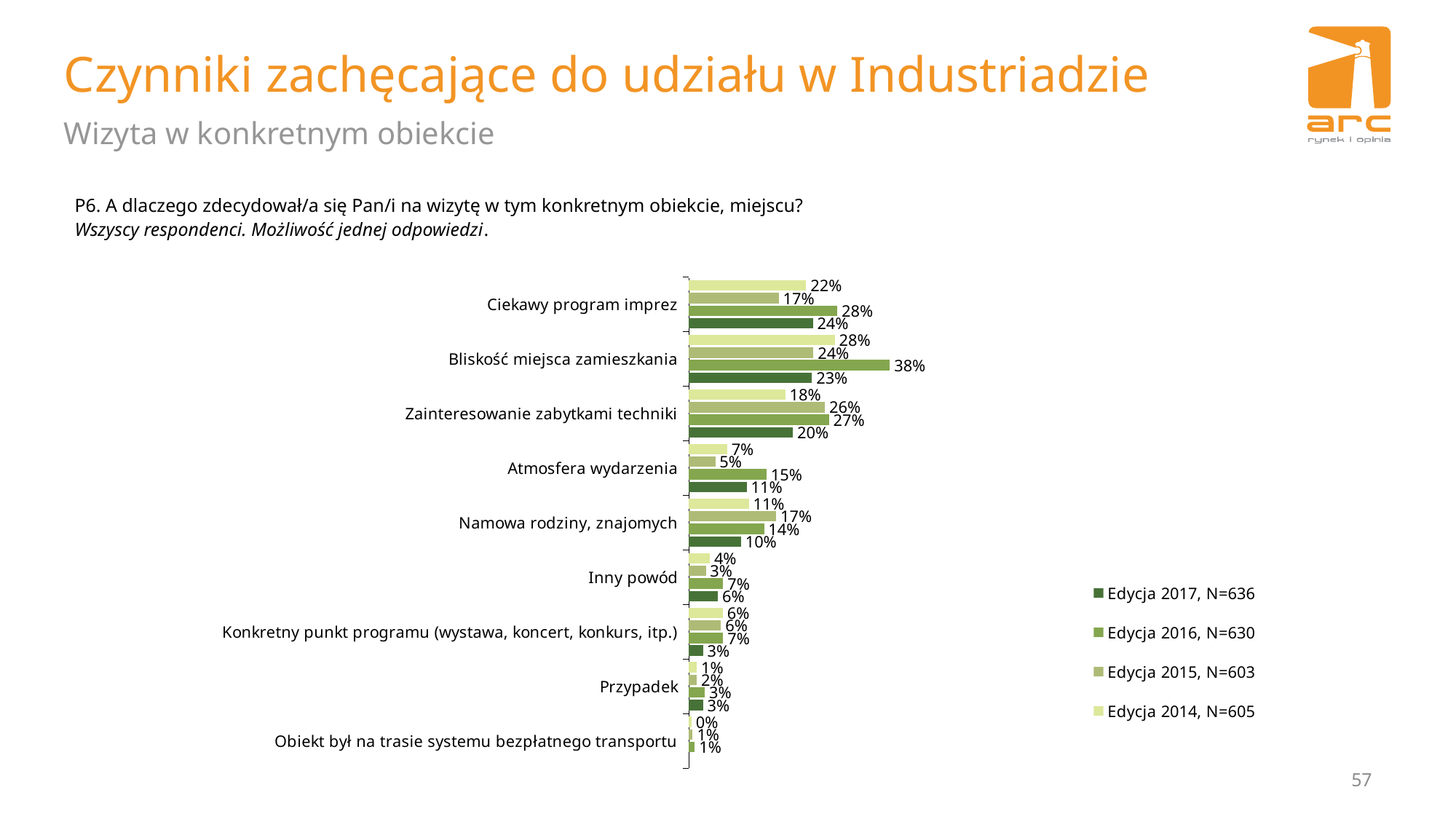
Which category has the lowest value in the Edycja 2014, N=605 series? Obiekt był na trasie systemu bezpłatnego transportu Which legend entry has the sample size N=603? Edycja 2015 What is the value for Ciekawy program imprez in the Edycja 2017, N=636 series? 24% What is the value for Bliskość miejsca zamieszkania in the Edycja 2016, N=630 series? 38% For Zainteresowanie zabytkami techniki, which is larger: the Edycja 2015, N=603 value or the Edycja 2014, N=605 value? Edycja 2015, N=603 What is the difference between the Edycja 2016, N=630 and Edycja 2017, N=636 values for Bliskość miejsca zamieszkania? 15% What is the value for Namowa rodziny, znajomych in the Edycja 2014, N=605 series? 11% What kind of chart is shown on the slide? bar chart How many categories are shown on the chart? 9 What is the value for Atmosfera wydarzenia in the Edycja 2015, N=603 series? 5% Which category has the highest value in the Edycja 2016, N=630 series? Bliskość miejsca zamieszkania How many series does the legend list? 4